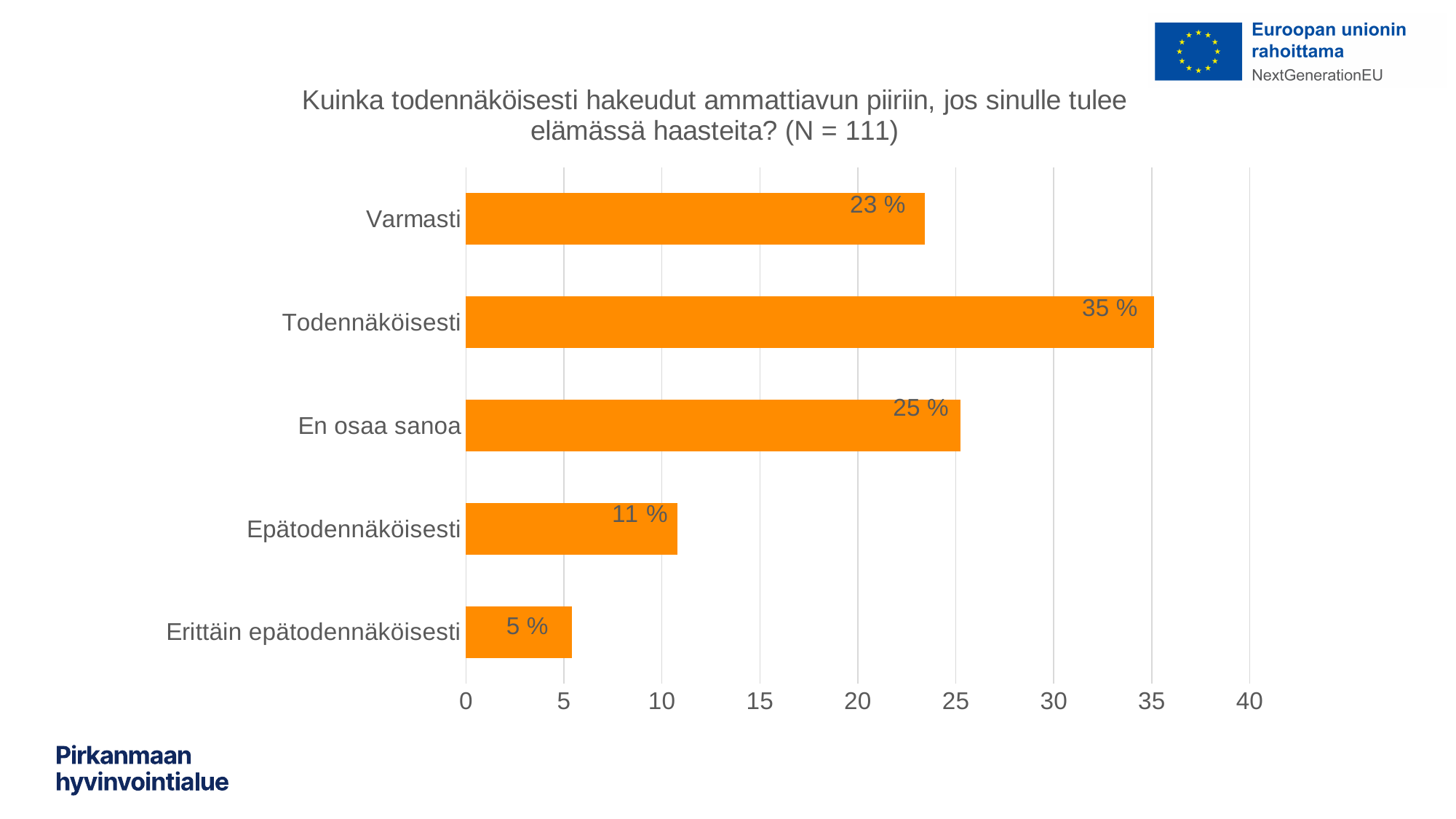
What is the value for Todennäköisesti? 35 % What is the difference between the values for Todennäköisesti and Varmasti? 12 % What is the value for Erittäin epätodennäköisesti? 5 % Which category has the lowest value? Erittäin epätodennäköisesti What is the value for Varmasti? 23 % How many categories are shown in the chart? 5 Is the value for Todennäköisesti greater or less than 30? greater What kind of chart is shown on the slide? bar chart What is the value for En osaa sanoa? 25 % Which category has the highest value? Todennäköisesti What is the value for Epätodennäköisesti? 11 % Which is larger, the value for En osaa sanoa or the value for Epätodennäköisesti? En osaa sanoa